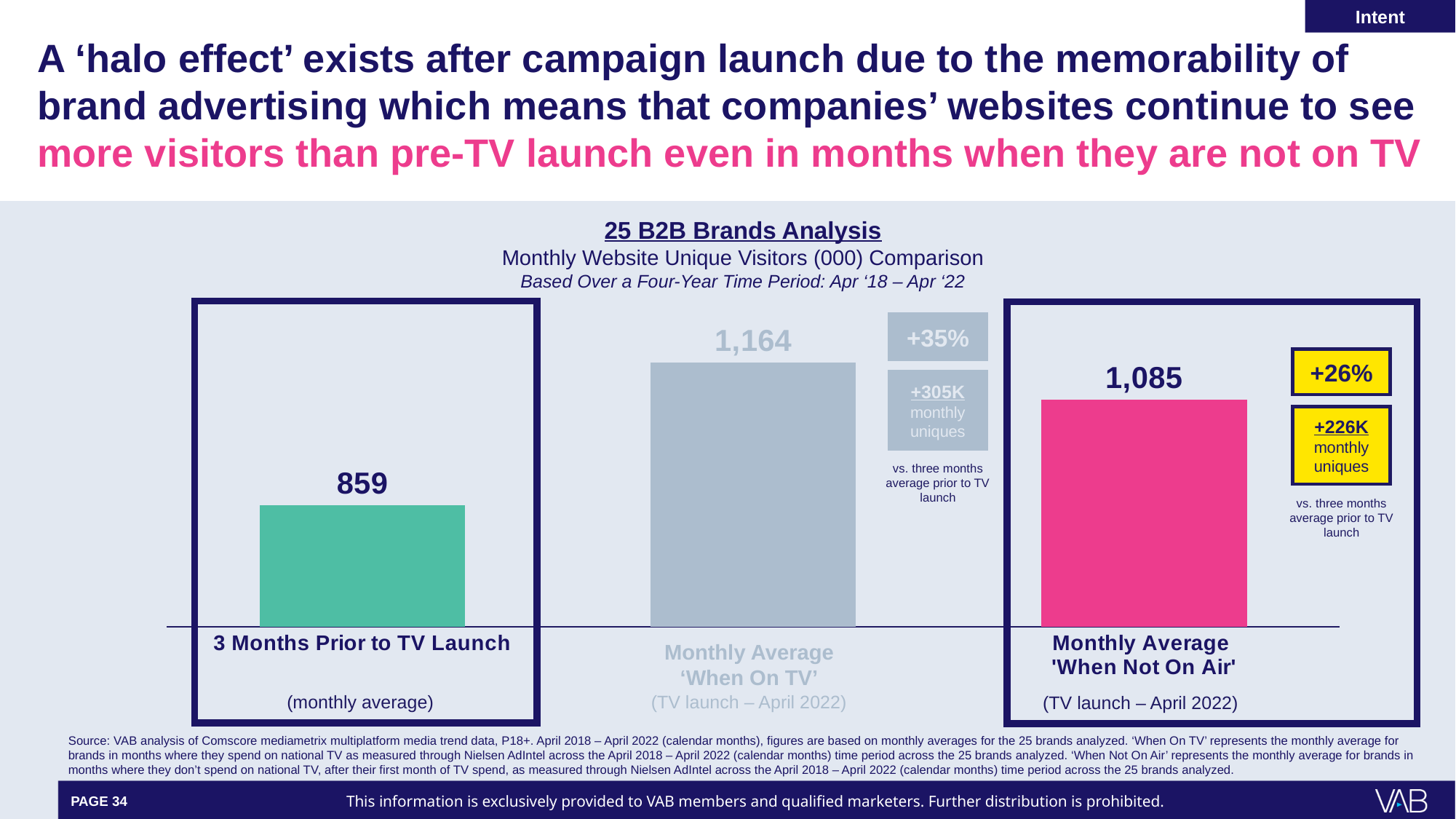
Which category has the lowest value on the chart? 3 Months Prior to TV Launch What is the Monthly Average 'When Not On Air' value shown on the chart? 1,085 What percentage increase is shown for the Monthly Average 'When Not On Air' versus the three months average prior to TV launch? +26% What is the difference between the Monthly Average 'When On TV' value and the Monthly Average 'When Not On Air' value? 79 How many bars are shown on the chart? 3 What is the monthly average of website unique visitors (000) for the 3 Months Prior to TV Launch? 859 What is the difference between the Monthly Average 'When On TV' value and the 3 Months Prior to TV Launch value? 305 What is the title of the chart? 25 B2B Brands Analysis Which is larger: the Monthly Average 'When Not On Air' value or the 3 Months Prior to TV Launch value? Monthly Average 'When Not On Air' What is the Monthly Average 'When On TV' value shown on the chart? 1,164 What kind of chart is shown on the slide? Bar chart Which category has the highest value on the chart? Monthly Average 'When On TV'